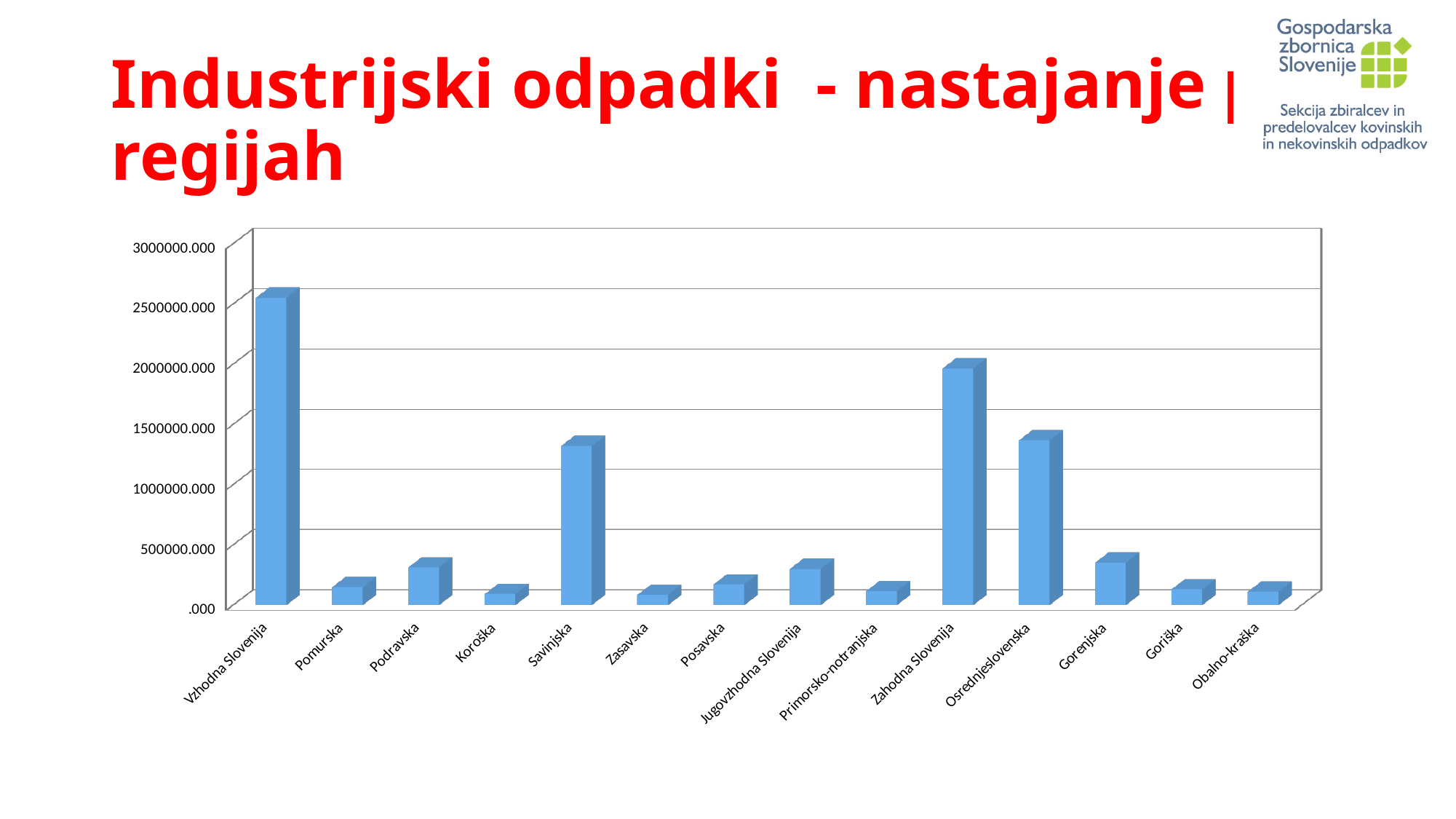
Is the value for Zahodna Slovenija greater or less than 1500000.000? greater Which is larger, the value for Zahodna Slovenija or the value for Savinjska? Zahodna Slovenija How many regions are shown on the x axis of the chart? 14 Is the value for Savinjska greater or less than 1000000.000? greater Which region has the highest bar in the chart? Vzhodna Slovenija Which is larger, the value for Gorenjska or the value for Koroška? Gorenjska Is the value for Vzhodna Slovenija greater or less than 2000000.000? greater What kind of chart is shown on the slide? bar chart What is the highest value shown on the vertical axis of the chart? 3000000.000